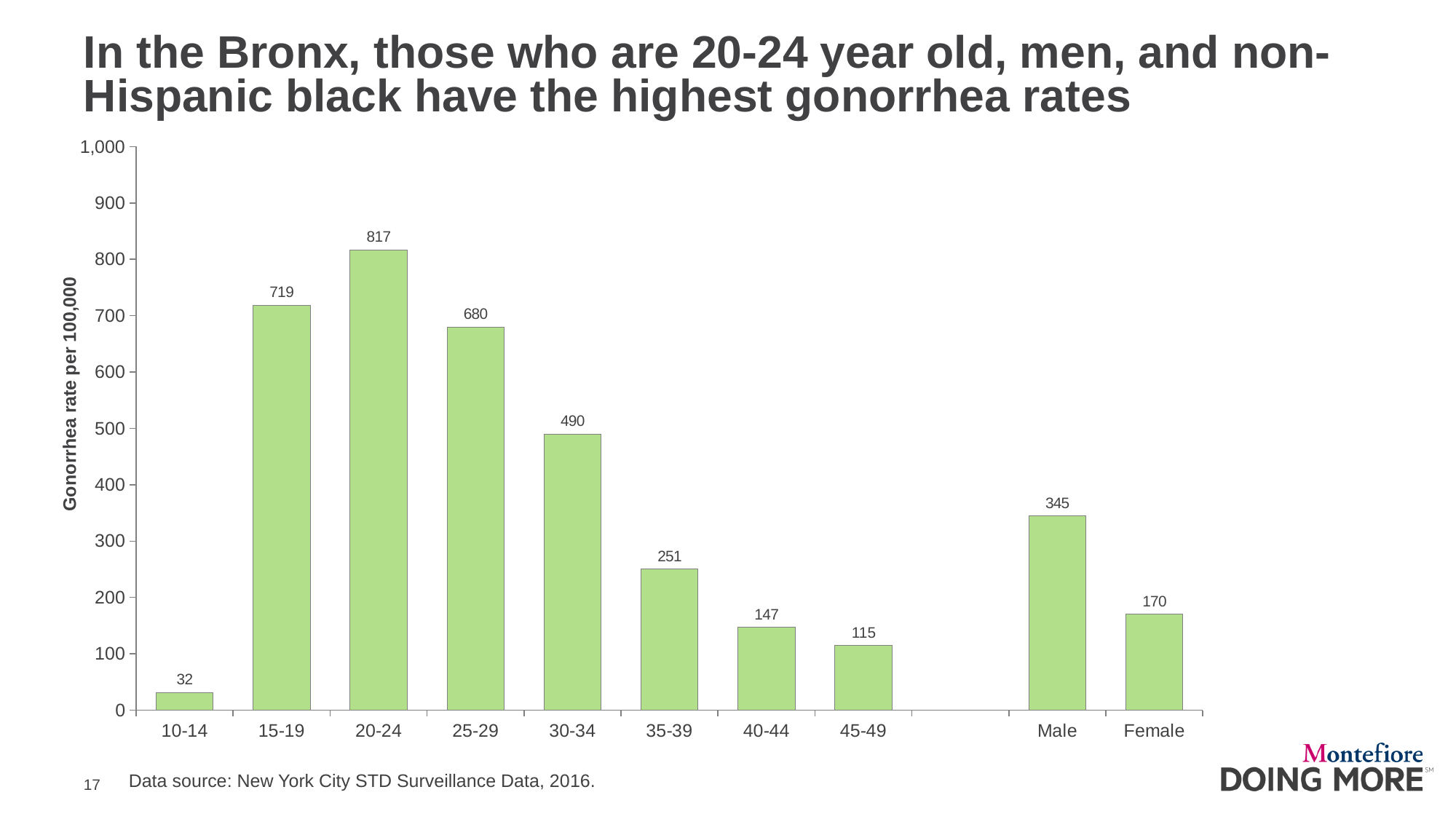
Is the gonorrhea rate for the 40-44 age group greater or less than 200? less What is the gonorrhea rate per 100,000 for the 45-49 age group? 115 What kind of chart is shown on the slide? bar chart Which age group has the lowest gonorrhea rate? 10-14 What is the difference between the gonorrhea rates for the 15-19 and 25-29 age groups? 39 How many bars are plotted on the chart? 10 What is the gonorrhea rate per 100,000 for the 20-24 age group? 817 What is the label of the vertical axis? Gonorrhea rate per 100,000 Which age group has the highest gonorrhea rate? 20-24 What is the difference between the gonorrhea rates for males and females? 175 What is the gonorrhea rate per 100,000 for males? 345 Which has a higher gonorrhea rate, the 30-34 age group or the 35-39 age group? 30-34